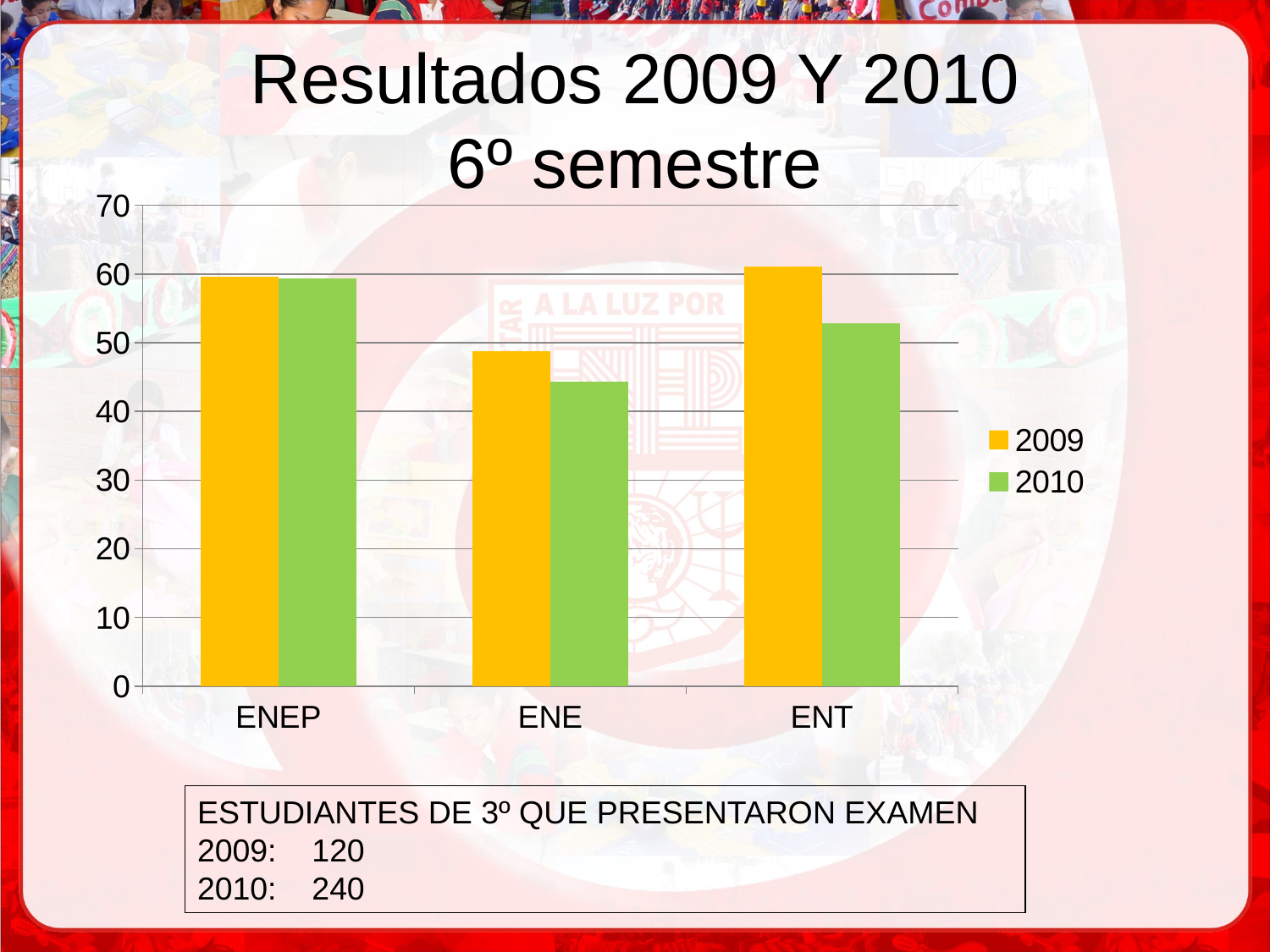
How many series does the chart's legend list? 2 Which category has the highest value in the 2010 series? ENEP What kind of chart is shown on the slide? bar chart How many categories are shown on the x axis of the chart? 3 Is the 2009 value for ENT greater or less than 60? greater Is the 2010 value for ENT greater or less than 50? greater Is the 2010 value for ENE greater or less than 50? less For ENT, which series has the larger value, 2009 or 2010? 2009 What is the title of the chart on the slide? Resultados 2009 Y 2010 6º semestre Which series does the legend show in green? 2010 Which category has the lowest value in the 2010 series? ENE